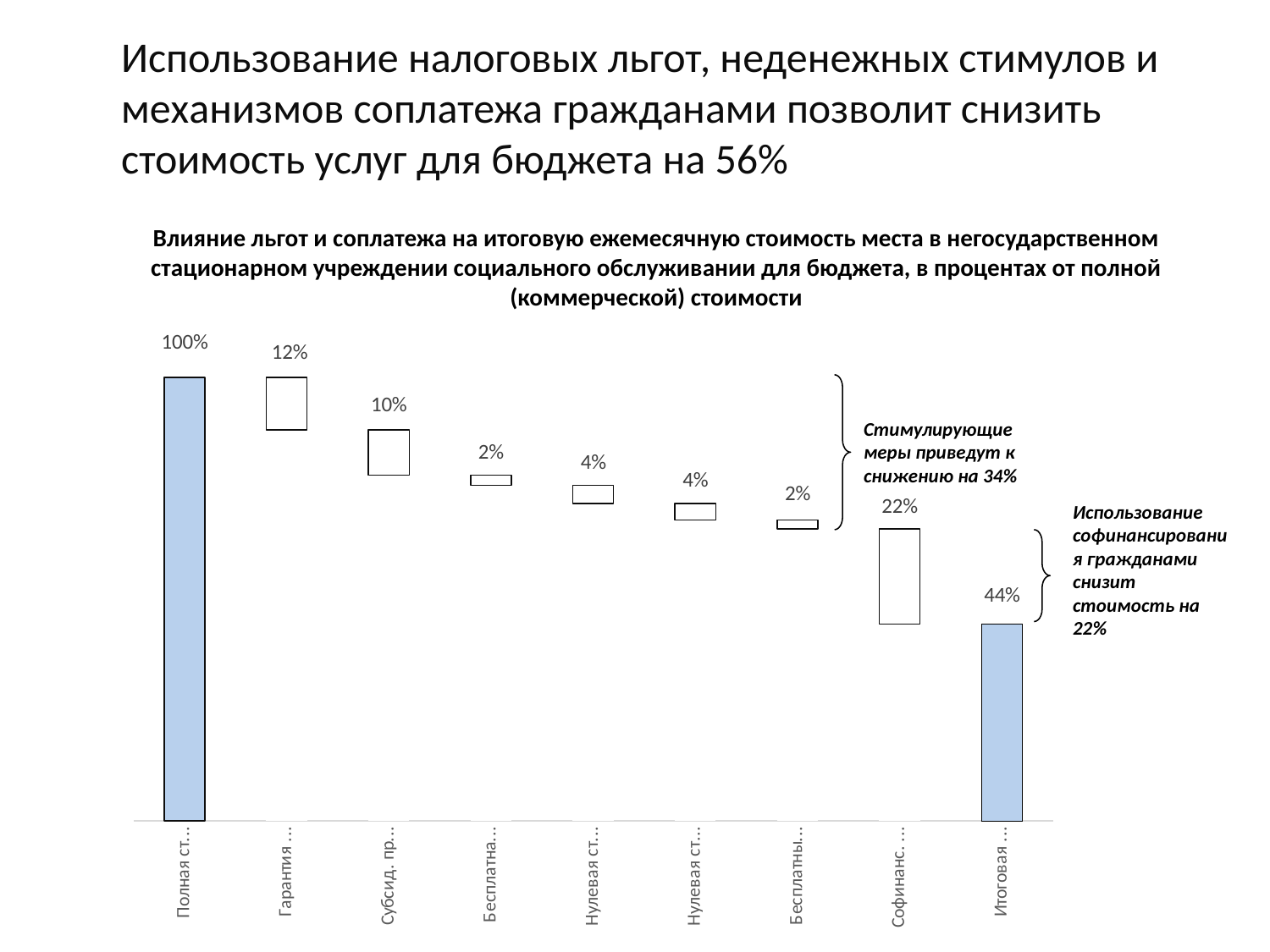
What is the difference between the first bar (100%) and the last bar (44%)? 56% Which bar has the highest value in the chart? Полная ст... (100%) What value is shown for the bar labelled "Софинанс. ..."? 22% What value is shown for the last bar ("Итоговая ...") in the chart? 44% How many bars are plotted in the chart? 9 What kind of chart is shown on the slide? Bar chart (waterfall) What value is shown for the bar labelled "Субсид. пр..."? 10% What value is shown for the bar labelled "Гарантия ..."? 12% What value is shown for the first bar ("Полная ст...") in the chart? 100% Which is larger: the value for "Гарантия ..." or the value for "Субсид. пр..."? Гарантия ... (12%) According to the annotation on the chart, by how much will the stimulating measures ("Стимулирующие меры") reduce the cost? 34% According to the slide title, by what percentage will the cost of services for the budget be reduced? 56%